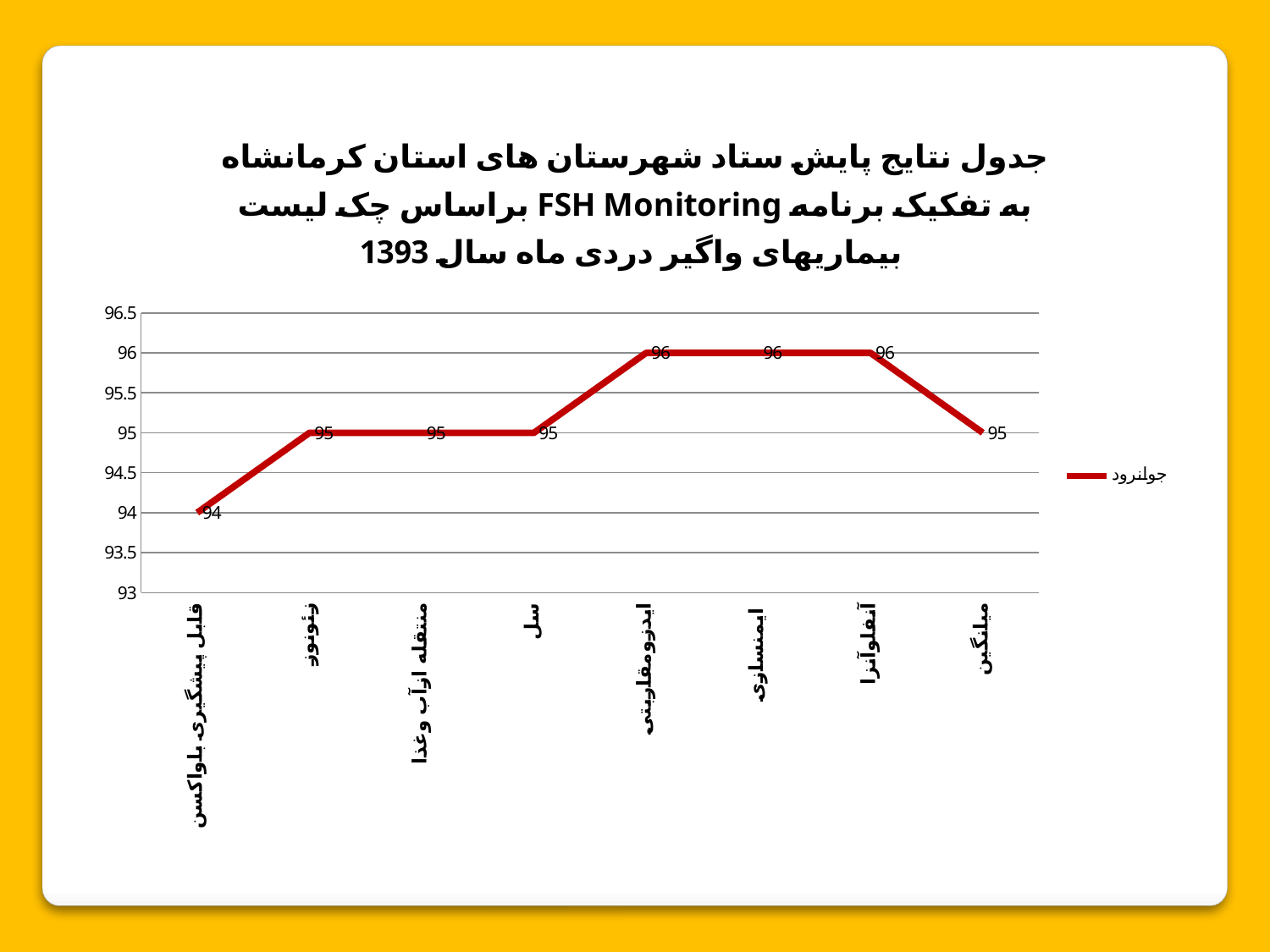
What colour is the plotted line? red What is the value for میانگین? 95 What is the value for قابل پیشگیری با واکسن? 94 How many series does the legend list? 1 What is the difference between the values for ایمنسازی and قابل پیشگیری با واکسن? 2 Which is larger, the value for ایدز و مقاربتی or the value for زئونوز? ایدز و مقاربتی What is the value for سل? 95 What is the name of the series shown in the legend? جوانرود Which category has the lowest value? قابل پیشگیری با واکسن What is the value for آنفلوآنزا? 96 How many categories are plotted on the x axis? 8 What kind of chart is shown on the slide? line chart